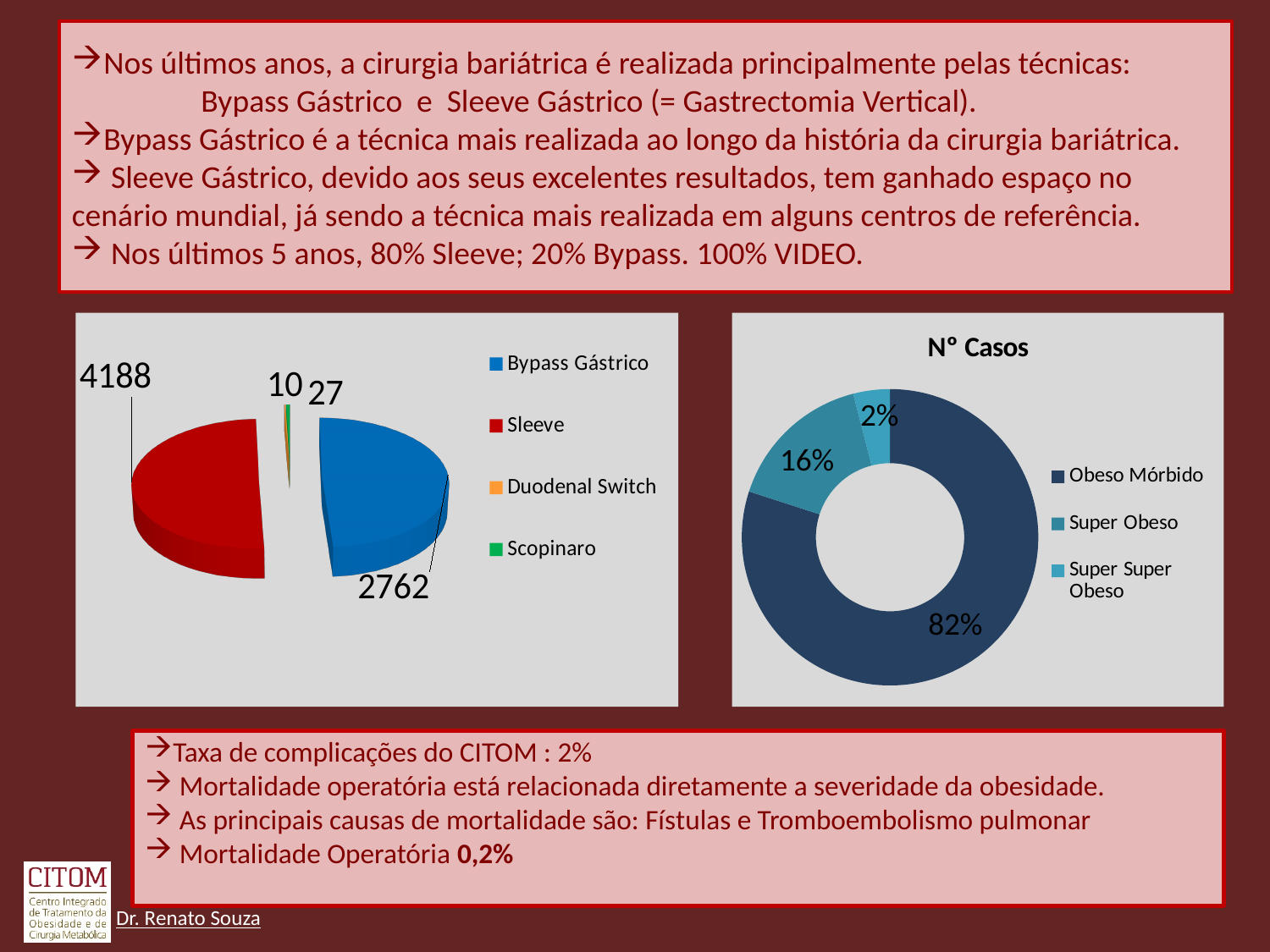
In the pie chart on the left of the slide, which is larger: Bypass Gástrico or Sleeve? Sleeve What kind of chart is the chart on the left of the slide? Pie chart In the pie chart on the left of the slide, what is the difference between the Sleeve value and the Bypass Gástrico value? 1426 What is the title of the chart on the right of the slide? Nº Casos In the 'Nº Casos' chart, what share is labelled for Obeso Mórbido? 82% In the pie chart on the left of the slide, what is the value for Sleeve? 4188 In the pie chart on the left of the slide, what is the value for Bypass Gástrico? 2762 In the 'Nº Casos' chart, what share is labelled for Super Obeso? 16% In the pie chart on the left of the slide, which category has the largest value? Sleeve How many categories does the legend of the pie chart on the left of the slide list? 4 In the 'Nº Casos' chart, what share is labelled for Super Super Obeso? 2% In the 'Nº Casos' chart, which category has the smallest share? Super Super Obeso